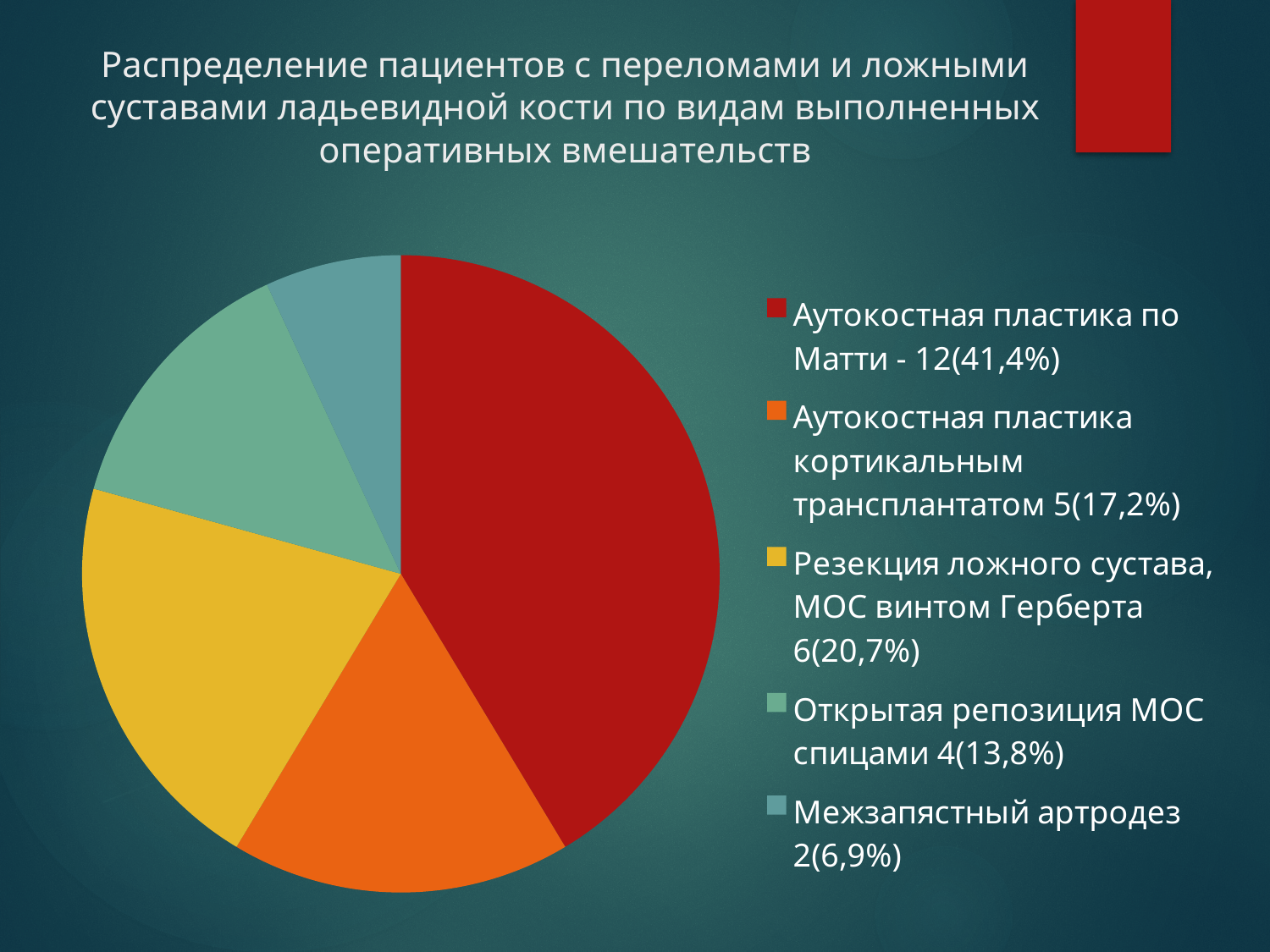
What colour is the slice for "Аутокостная пластика кортикальным трансплантатом"? orange What is the difference in number of patients between "Аутокостная пластика по Матти" and "Аутокостная пластика кортикальным трансплантатом"? 7 Which has more patients: "Резекция ложного сустава, МОС винтом Герберта" or "Открытая репозиция МОС спицами"? Резекция ложного сустава, МОС винтом Герберта How many slices does the pie chart have? 5 How many patients are in the category "Открытая репозиция МОС спицами"? 4 What kind of chart is shown on the slide? pie chart What share of the pie does "Межзапястный артродез" represent? 6,9% Which category has the smallest slice of the pie? Межзапястный артродез Which category has the largest slice of the pie? Аутокостная пластика по Матти What is the total number of patients across all categories in the pie chart? 29 What percentage is shown for "Резекция ложного сустава, МОС винтом Герберта"? 20,7% How many patients are in the category "Аутокостная пластика по Матти"? 12